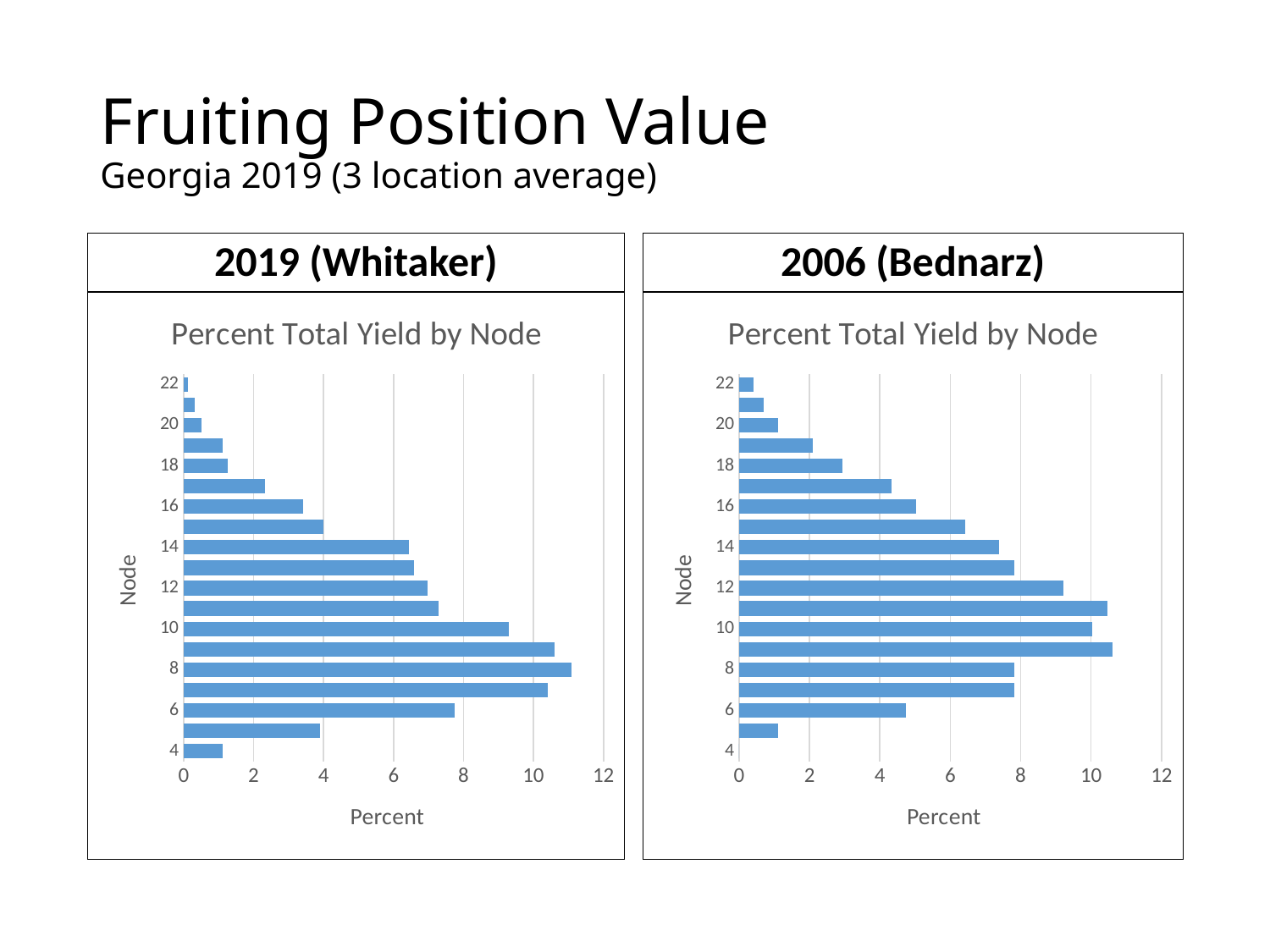
In the 2019 (Whitaker) chart, is the value for node 16 greater or less than 4? less In the 2019 (Whitaker) chart, is the value for node 8 greater or less than 10? greater In the 2006 (Bednarz) chart, which is larger, the value for node 12 or the value for node 16? Node 12 What is the x-axis title of the 2006 (Bednarz) chart? Percent In the 2006 (Bednarz) chart, is the value for node 18 greater or less than 4? less In the 2019 (Whitaker) chart, which node has the highest percent of total yield? Node 8 In the 2019 (Whitaker) chart, which is larger, the value for node 10 or the value for node 14? Node 10 What kind of chart is the 2019 (Whitaker) chart? bar chart In the 2019 (Whitaker) chart, how many nodes (bars) are plotted? 19 In the 2006 (Bednarz) chart, do the values rise or fall going from node 12 up to node 22? fall In the 2019 (Whitaker) chart, which node has the lowest percent of total yield? Node 22